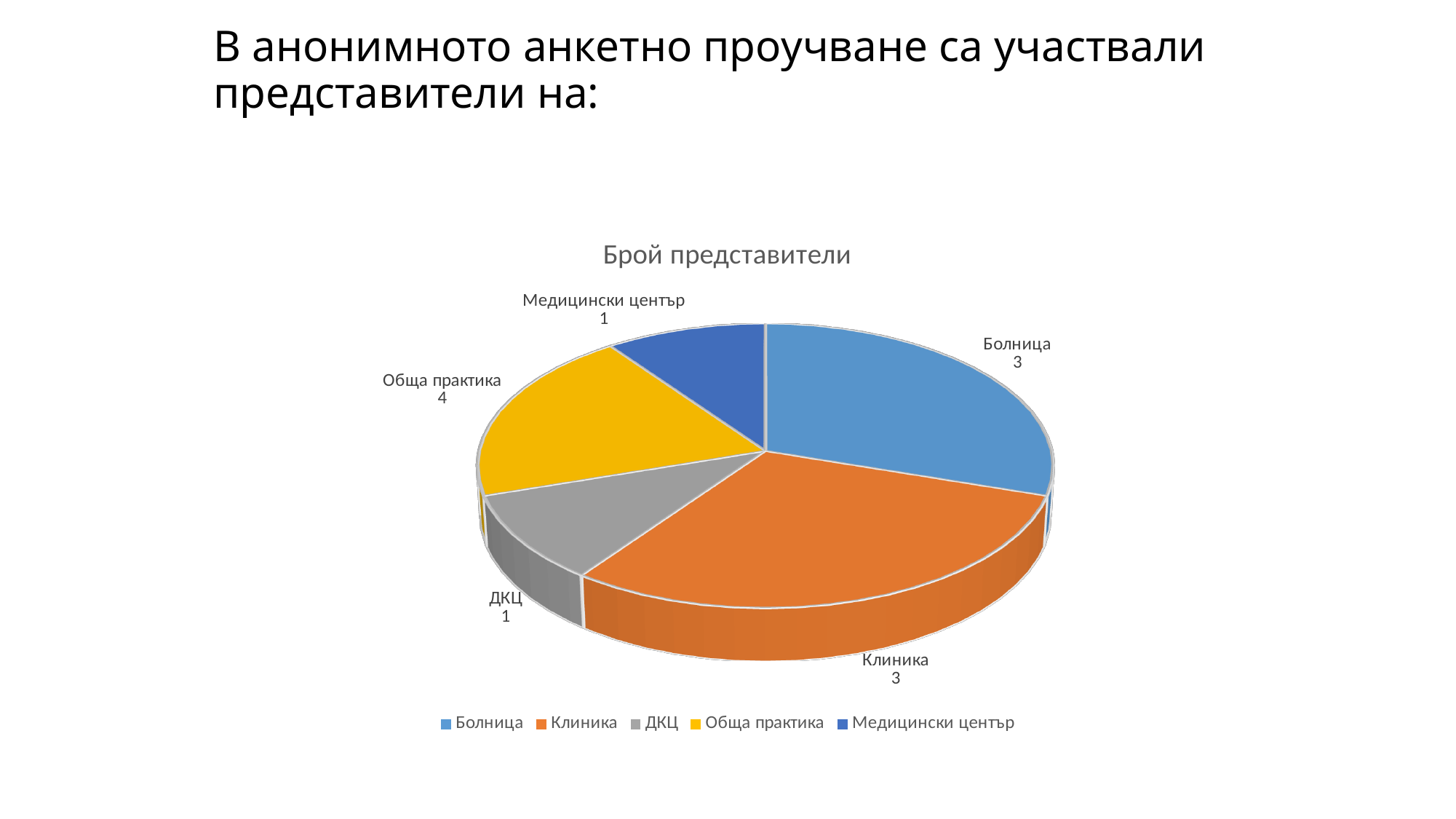
What is the title of the chart? Брой представители What is the value for ДКЦ? 1 What kind of chart is shown on the slide? pie chart Which has a larger value according to the data labels, Обща практика or Медицински център? Обща практика What is the difference between the values for Обща практика and ДКЦ? 3 What is the value for Медицински център? 1 What is the value for Болница? 3 What is the value for Клиника? 3 What is the value for Обща практика? 4 What is the total of all the values shown in the pie chart? 12 How many categories does the pie chart have? 5